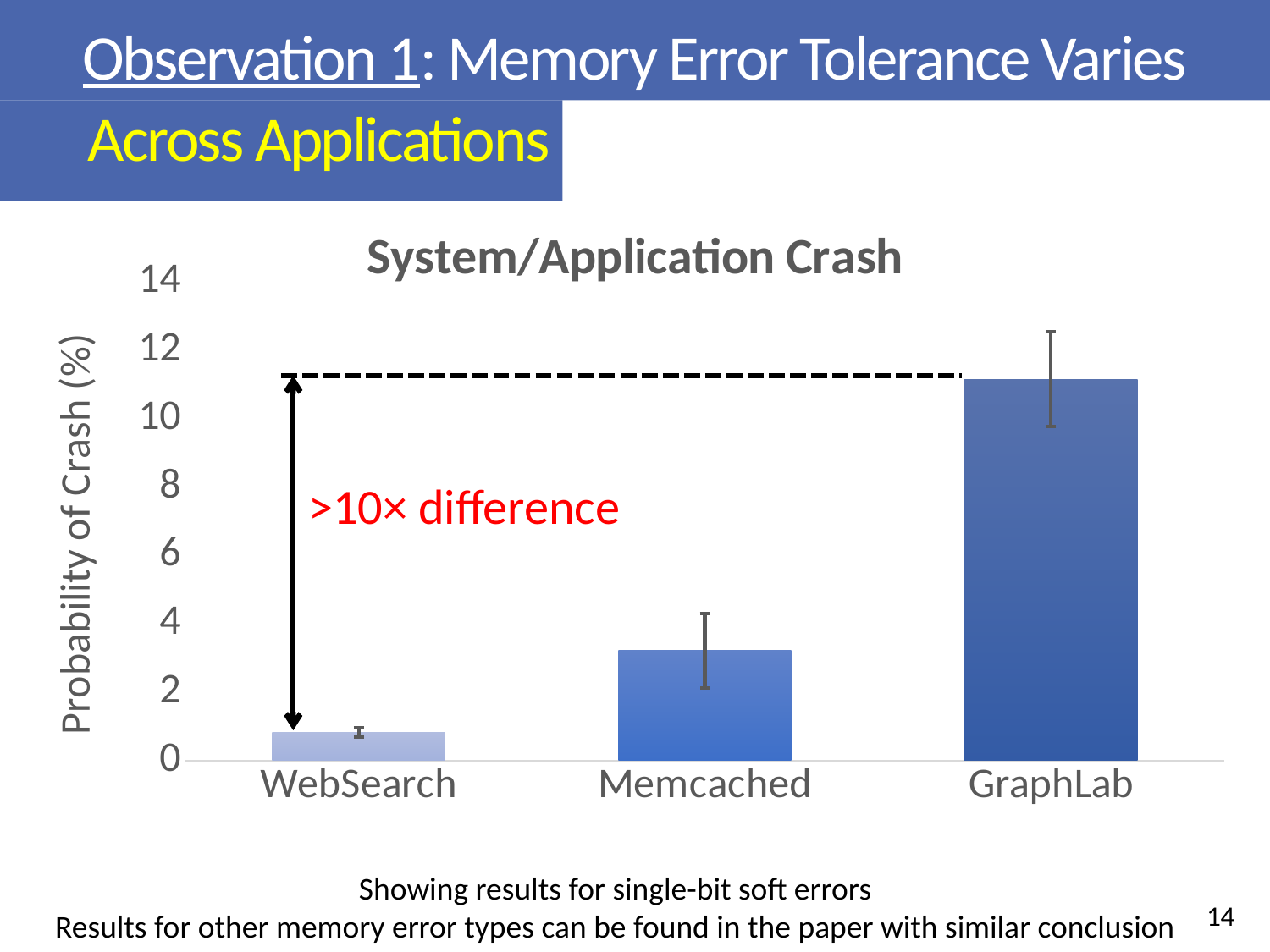
How many applications (categories) are plotted in the chart? 3 What is the label of the vertical axis? Probability of Crash (%) Which has a higher probability of crash, Memcached or GraphLab? GraphLab Is the probability of crash for WebSearch greater or less than 2? less Which application has the highest probability of crash? GraphLab What kind of chart is shown on the slide? bar chart Which has a higher probability of crash, WebSearch or Memcached? Memcached What is the title of the chart? System/Application Crash Is the probability of crash for GraphLab greater or less than 10? greater Which application has the lowest probability of crash? WebSearch Is the probability of crash for Memcached greater or less than 4? less Do the bar values rise or fall from left to right across the categories? rise